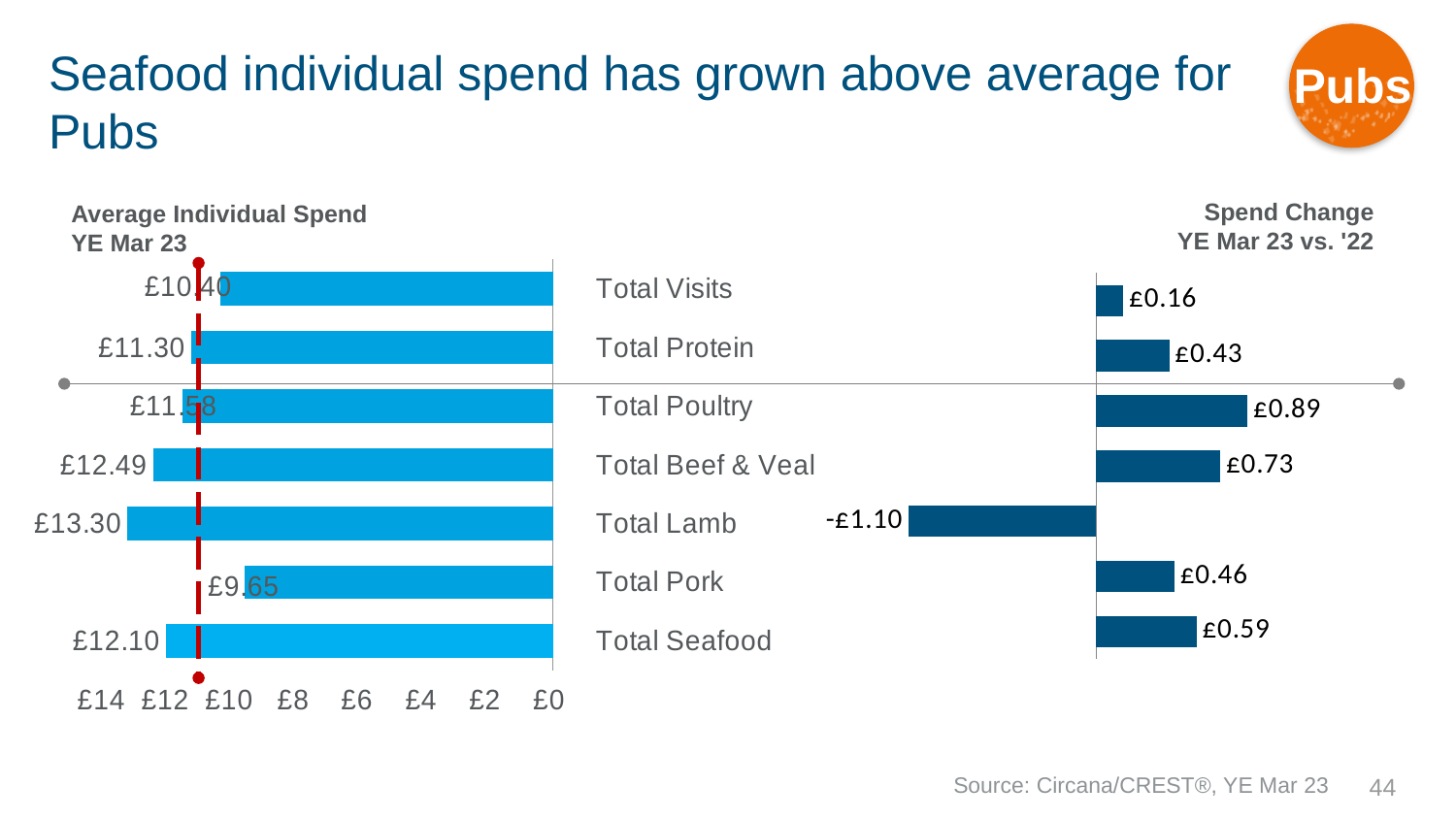
In the Spend Change YE Mar 23 vs. '22 chart, what is the difference between Total Poultry and Total Visits? £0.73 In the Spend Change YE Mar 23 vs. '22 chart, what is the value for Total Seafood? £0.59 In the Spend Change YE Mar 23 vs. '22 chart, which category has the highest value? Total Poultry In the Average Individual Spend YE Mar 23 chart, which category has the highest value? Total Lamb In the Average Individual Spend YE Mar 23 chart, what is the value for Total Lamb? £13.30 In the Average Individual Spend YE Mar 23 chart, which category has the lowest value? Total Pork In the Spend Change YE Mar 23 vs. '22 chart, which is larger, Total Pork or Total Protein? Total Pork In the Average Individual Spend YE Mar 23 chart, what is the value for Total Seafood? £12.10 In the Spend Change YE Mar 23 vs. '22 chart, what is the value for Total Lamb? -£1.10 In the Average Individual Spend YE Mar 23 chart, what is the difference between Total Beef & Veal and Total Visits? £2.09 What type of chart is the Spend Change YE Mar 23 vs. '22 chart? Bar chart How many categories are shown in the Average Individual Spend YE Mar 23 chart? 7